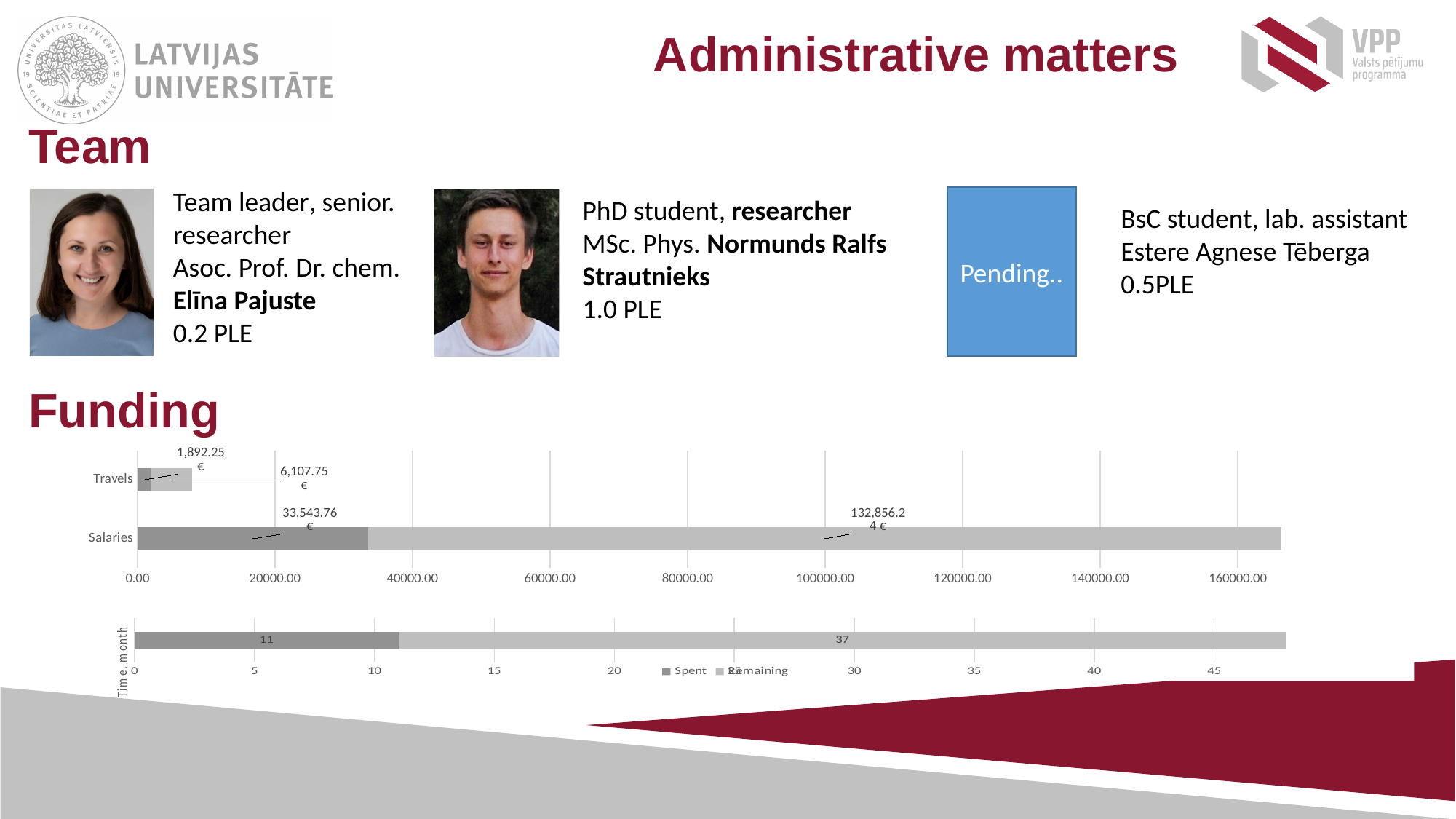
In the upper funding chart, how many categories are shown on the vertical axis? 2 In the lower time chart, how many months are shown as Spent? 11 In the upper funding chart, what is the Spent value for Salaries? 33,543.76 € In the upper funding chart, which category has the larger Spent value, Travels or Salaries? Salaries In the upper funding chart, what is the Remaining value for Travels? 6,107.75 € In the upper funding chart, what is the Spent value for Travels? 1,892.25 € In the lower time chart, what is the total number of months in the stacked bar? 48 In the upper funding chart, what is the total of the stacked bar for Salaries? 166,400.00 € In the upper funding chart, what is the total of the stacked bar for Travels? 8,000.00 € In the lower time chart, how many months are shown as Remaining? 37 In the upper funding chart, what is the Remaining value for Salaries? 132,856.24 € How many series does the legend below the lower chart list? 2